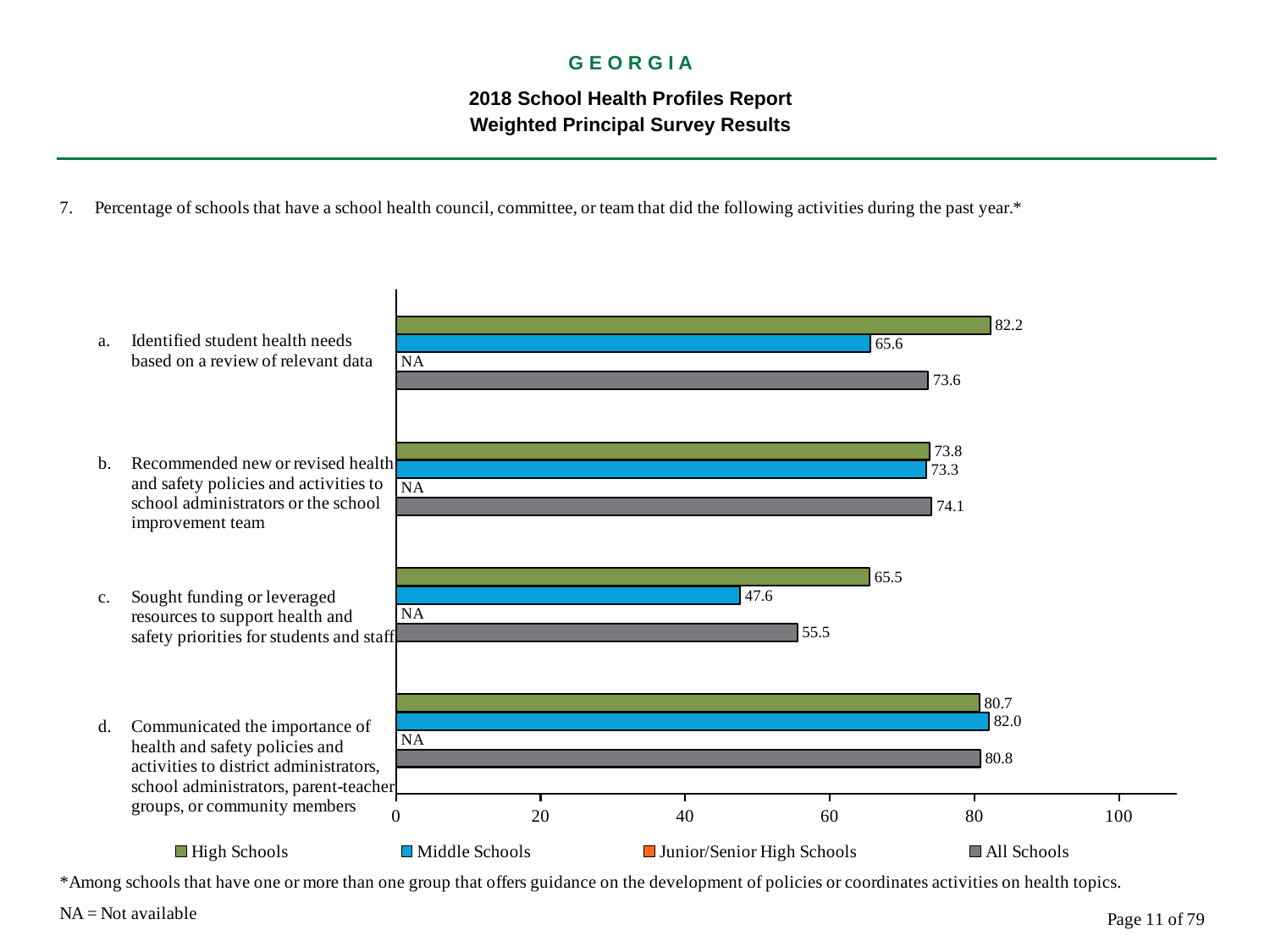
What is the value for High Schools for activity a, identified student health needs based on a review of relevant data? 82.2 What is the difference between the High Schools and Middle Schools values for activity a? 16.6 What is the value for Middle Schools for activity c, sought funding or leveraged resources to support health and safety priorities? 47.6 Which activity has the highest High Schools value? a. Identified student health needs based on a review of relevant data What value is shown for Junior/Senior High Schools for each activity? NA How many activities (categories) are shown in the chart? 4 For activity c, which is larger: the High Schools value or the All Schools value? High Schools Which activity has the lowest All Schools value? c. Sought funding or leveraged resources to support health and safety priorities for students and staff What is the All Schools value for activity b, recommended new or revised health and safety policies and activities? 74.1 What kind of chart is shown on the slide? Bar chart What is the Middle Schools value for activity d, communicated the importance of health and safety policies and activities? 82.0 How many series does the legend list? 4